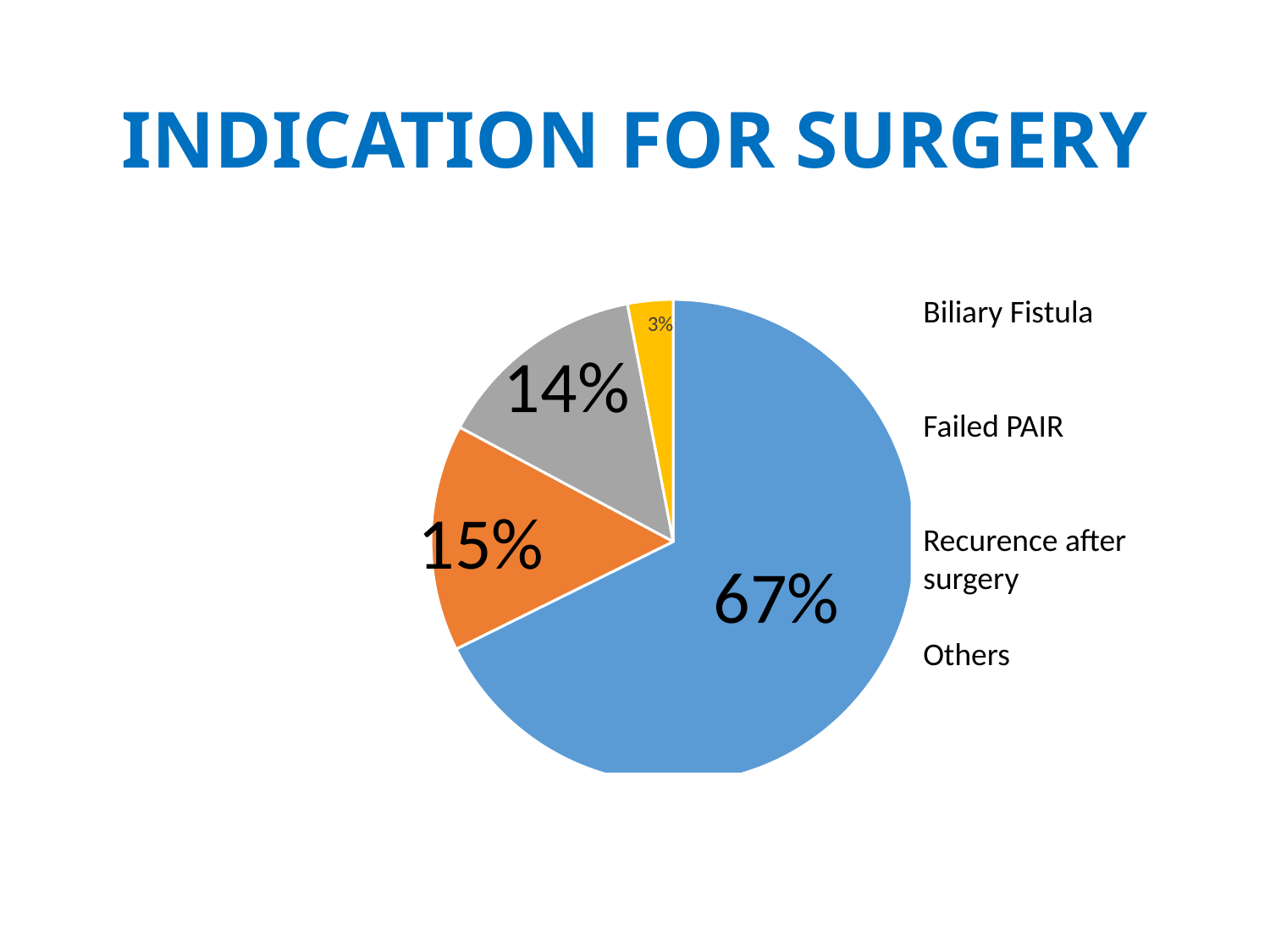
What percentage is labelled on the orange slice of the pie chart? 15% What is the difference in percentage points between the blue slice and the orange slice? 52 What kind of chart is shown on the slide? pie chart What percentage is labelled on the blue slice of the pie chart? 67% What percentage is labelled on the gray slice of the pie chart? 14% Which slice is larger, the orange slice or the gray slice? orange slice How many slices does the pie chart have? 4 What is the smallest percentage shown on the pie chart? 3% What is the title of the chart on the slide? INDICATION FOR SURGERY What is the largest percentage shown on the pie chart? 67% How many entries does the legend of the pie chart list? 4 What percentage is labelled on the yellow slice of the pie chart? 3%